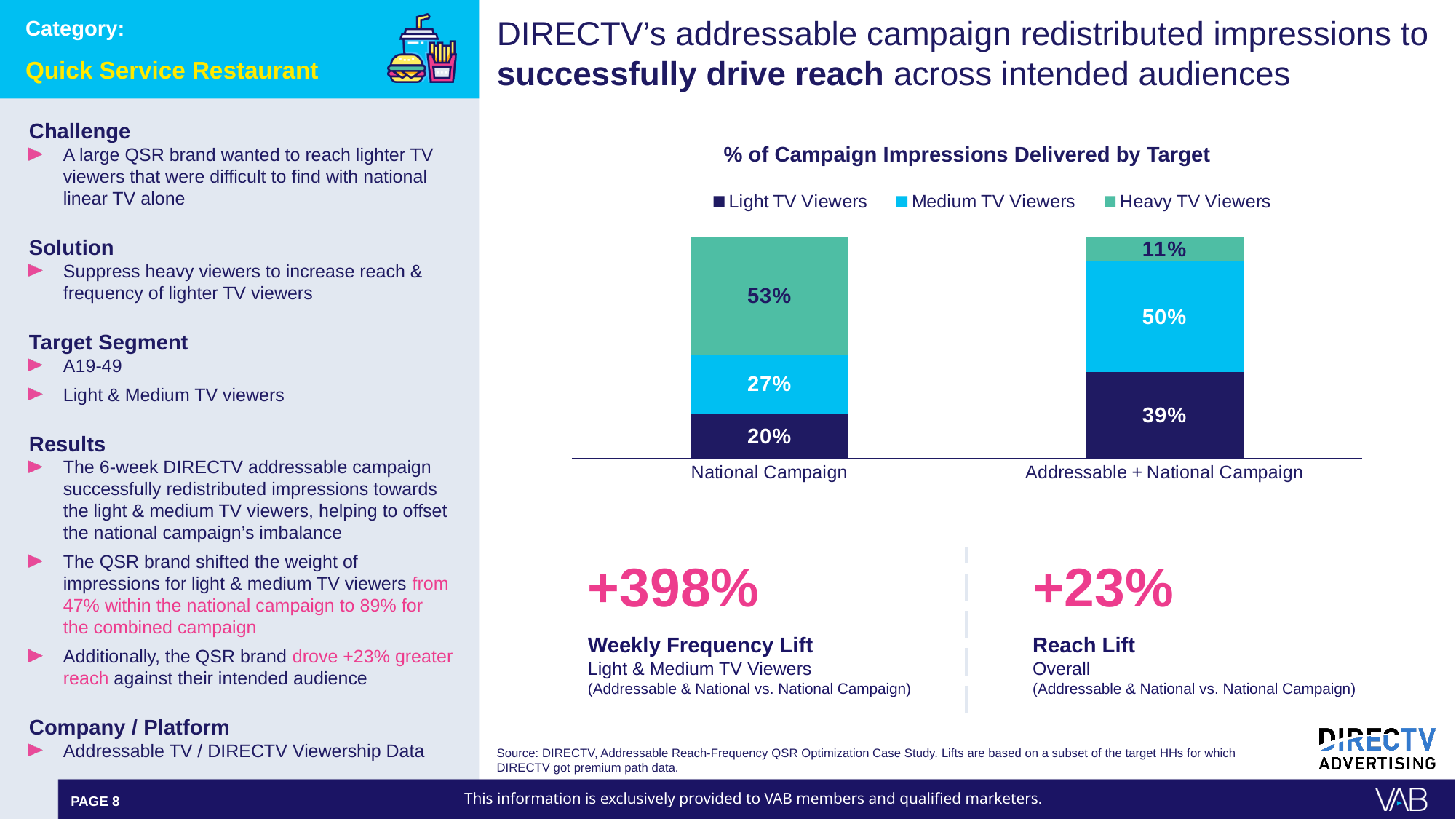
Which viewer segment received the largest share of impressions in the National Campaign? Heavy TV Viewers What is the chart's title? % of Campaign Impressions Delivered by Target What share of impressions went to Medium TV Viewers in the National Campaign? 27% What share of impressions went to Light TV Viewers in the Addressable + National Campaign? 39% What share of impressions went to Heavy TV Viewers in the National Campaign? 53% What is the difference in the Light TV Viewers share between the Addressable + National Campaign and the National Campaign? 19 percentage points Which campaign has the larger share of impressions for Medium TV Viewers? Addressable + National Campaign Which viewer segment received the smallest share of impressions in the Addressable + National Campaign? Heavy TV Viewers How many campaign categories are shown on the x axis? 2 How many series does the legend list? 3 What share of impressions went to Heavy TV Viewers in the Addressable + National Campaign? 11% What kind of chart is shown on the slide? Stacked bar chart